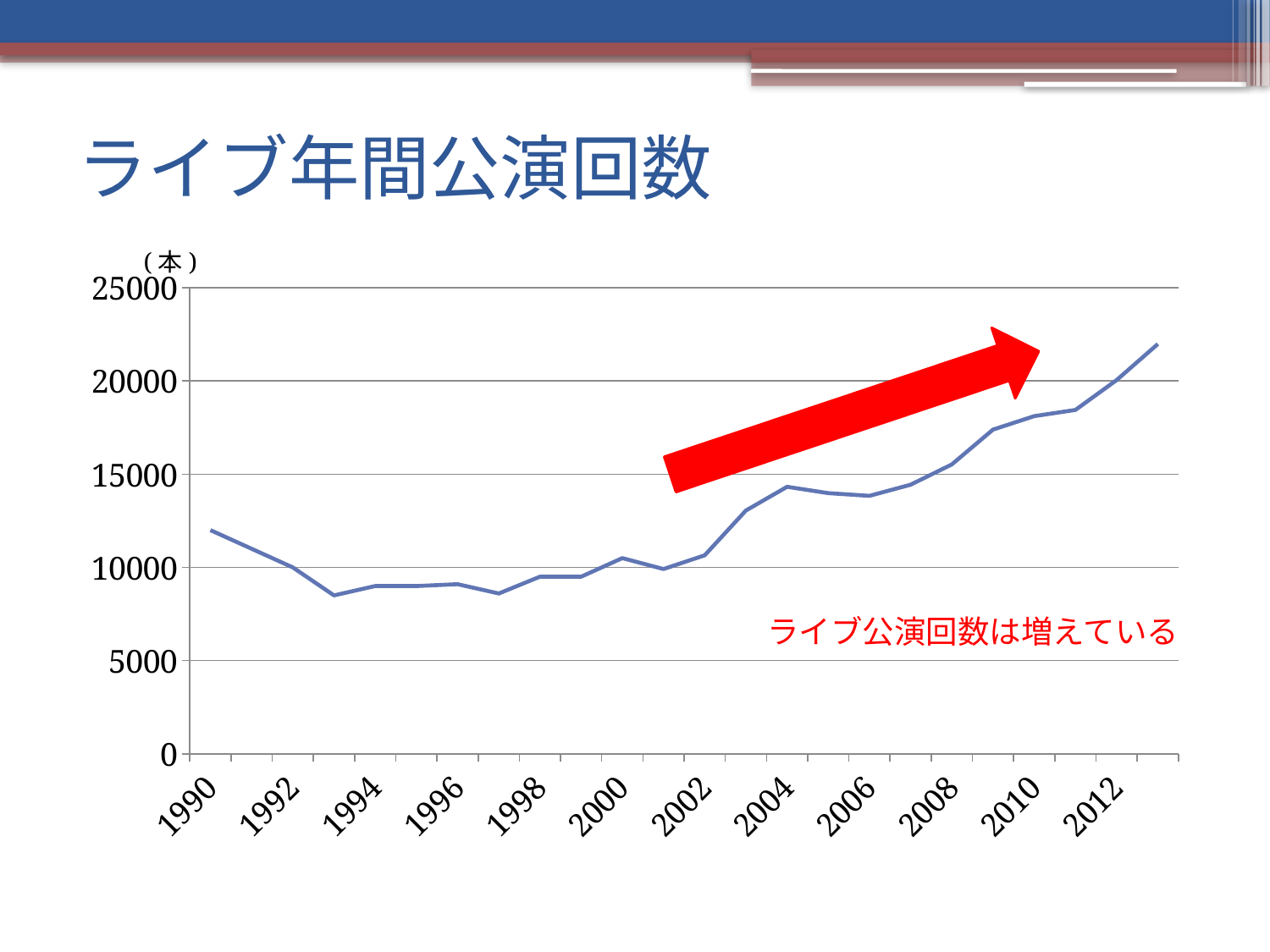
Overall, do the values rise or fall from 2002 to 2013? Rise Which year has the highest value on the chart? 2013 Is the value for 2013 greater or less than 20000? greater What is the title of the chart? ライブ年間公演回数 Is the value for 2009 greater or less than 15000? greater Is the value for 2004 greater or less than 15000? less Which year has the larger value, 1990 or 2013? 2013 What kind of chart is shown on the slide? Line chart What unit is shown at the top of the y axis? 本